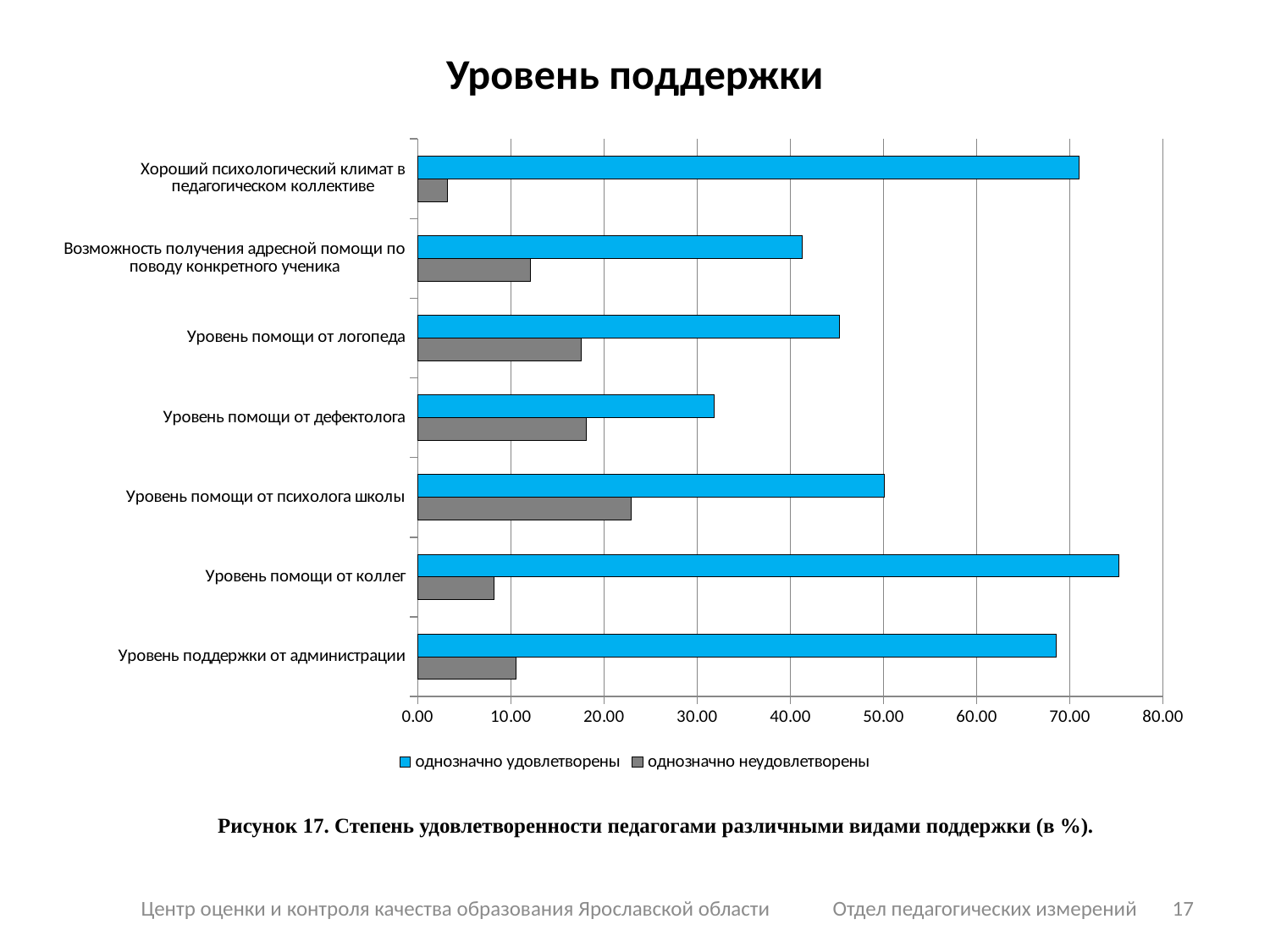
Is the 'однозначно удовлетворены' value for 'Уровень помощи от дефектолога' greater or less than 40.00? less Which is larger for 'однозначно удовлетворены': 'Уровень помощи от логопеда' or 'Уровень помощи от дефектолога'? Уровень помощи от логопеда Is the 'однозначно удовлетворены' value for 'Уровень помощи от коллег' greater or less than 70.00? greater Which category has the lowest value for 'однозначно удовлетворены'? Уровень помощи от дефектолога Which category has the lowest value for 'однозначно неудовлетворены'? Хороший психологический климат в педагогическом коллективе What kind of chart is shown on the slide? bar chart Which category has the highest value for 'однозначно неудовлетворены'? Уровень помощи от психолога школы What is the title of the chart? Уровень поддержки How many series does the legend list? 2 How many categories are shown on the chart? 7 Is the 'однозначно неудовлетворены' value for 'Возможность получения адресной помощи по поводу конкретного ученика' greater or less than 20.00? less Which category has the highest value for 'однозначно удовлетворены'? Уровень помощи от коллег